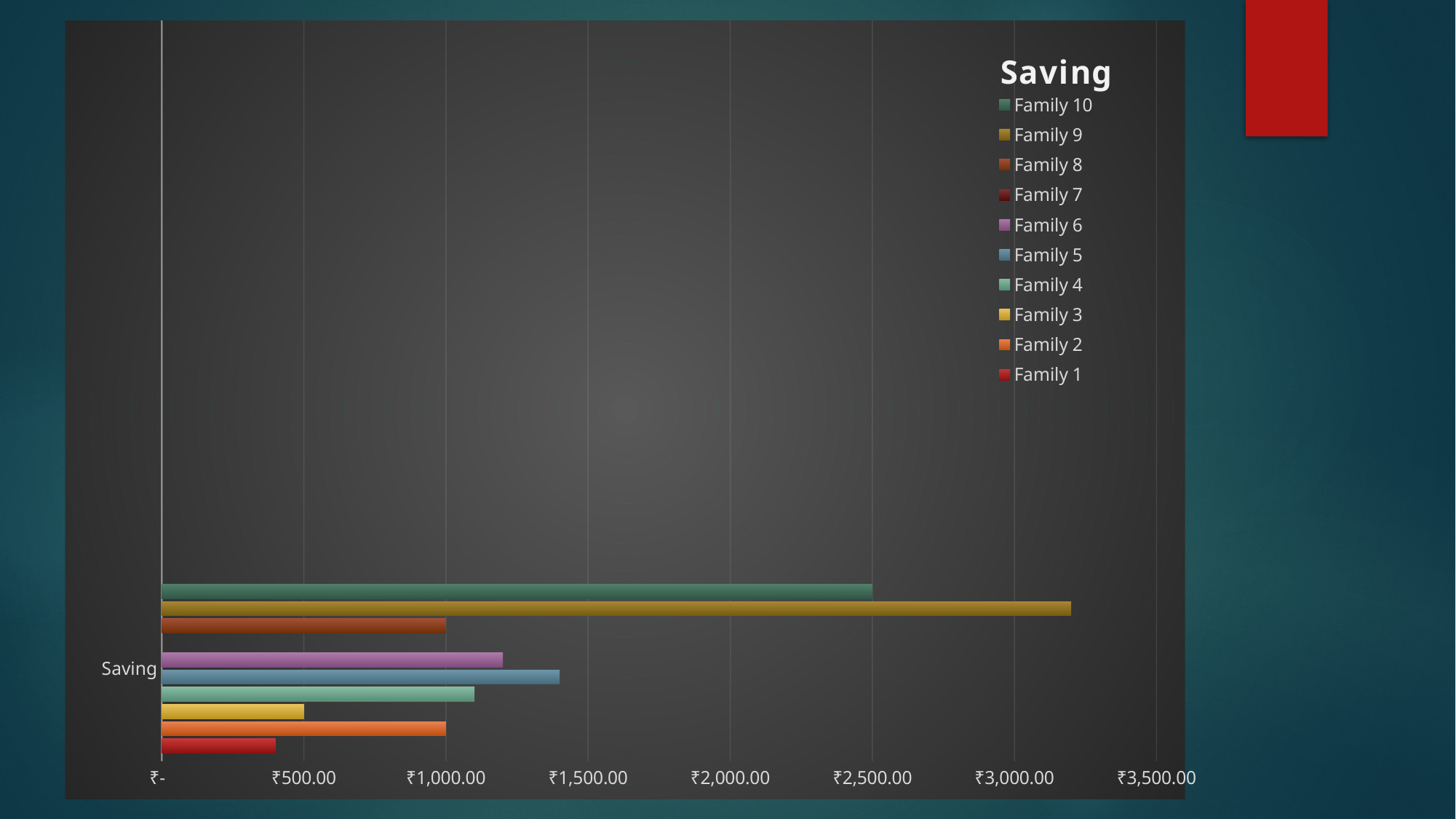
Is the saving value for Family 1 greater or less than ₹500.00? less What kind of chart is shown on the slide? bar chart What is the title of the chart? Saving How many series does the legend list? 10 Is the saving value for Family 9 greater or less than ₹3,000.00? greater Which is larger, the saving value for Family 10 or for Family 9? Family 9 What is the saving value for Family 10? ₹2,500.00 What is the saving value for Family 3? ₹500.00 How many categories are shown on the vertical axis? 1 Which family has the highest saving value? Family 9 Which is larger, the saving value for Family 5 or for Family 4? Family 5 What is the saving value for Family 8? ₹1,000.00